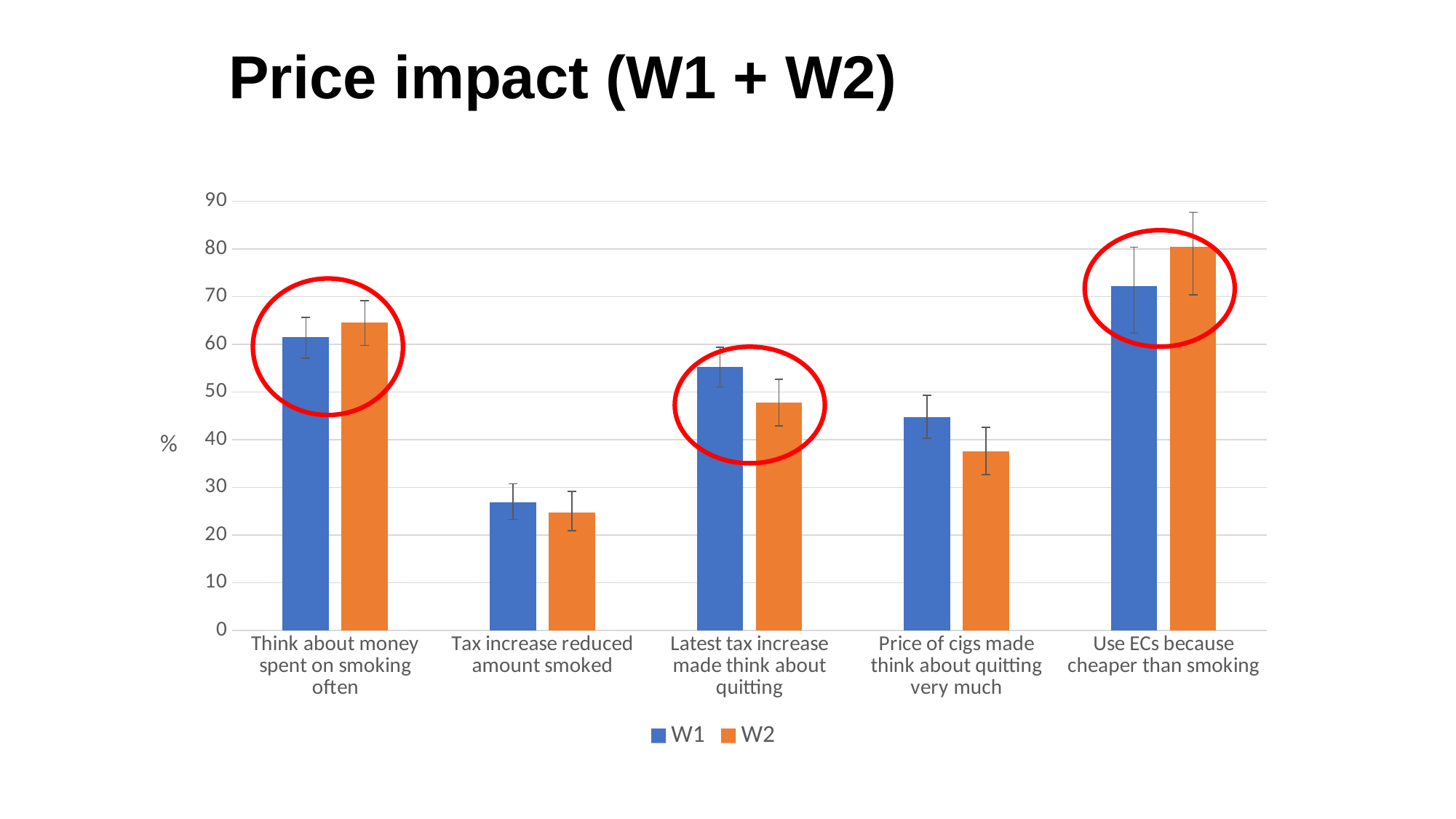
Is the W1 value for 'Latest tax increase made think about quitting' greater or less than 50? greater Is the W2 value for 'Use ECs because cheaper than smoking' greater or less than 70? greater Is the W1 value for 'Tax increase reduced amount smoked' greater or less than 30? less For 'Use ECs because cheaper than smoking', which is larger, W1 or W2? W2 How many categories are shown on the x axis? 5 What label is shown on the y axis? % What is the title of the chart? Price impact (W1 + W2) For 'Latest tax increase made think about quitting', which is larger, W1 or W2? W1 What kind of chart is shown on the slide? Bar chart Which category has the highest W1 value? Use ECs because cheaper than smoking Which category has the lowest W2 value? Tax increase reduced amount smoked How many series does the legend list? 2